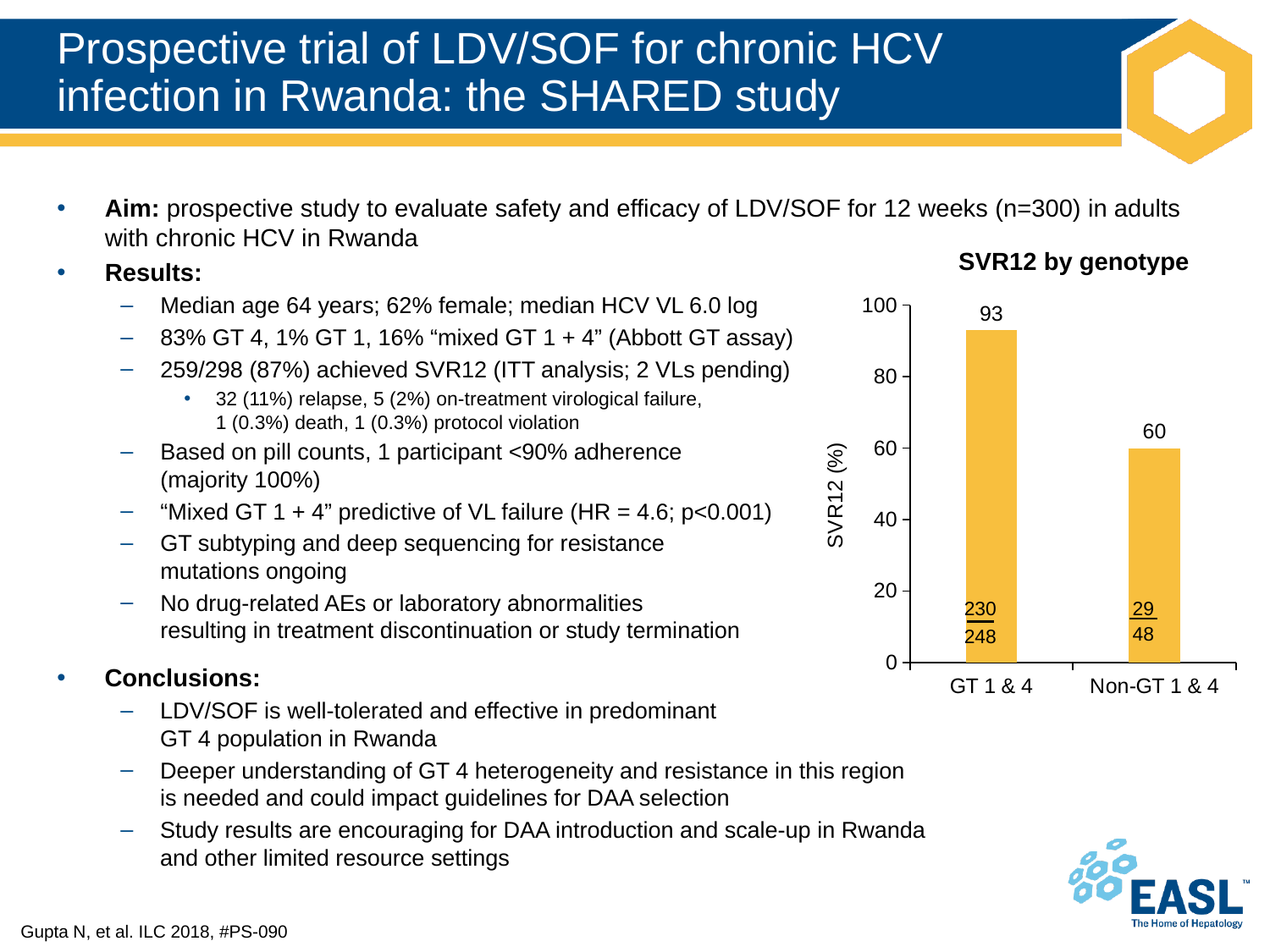
What is the SVR12 value for GT 1 & 4? 93 What fraction is printed on the GT 1 & 4 bar? 230/248 Which has a larger SVR12, GT 1 & 4 or Non-GT 1 & 4? GT 1 & 4 Is the SVR12 value for Non-GT 1 & 4 greater or less than 80? less How many genotype categories are shown in the chart? 2 Which genotype group has the highest SVR12? GT 1 & 4 What is the title of the chart? SVR12 by genotype What is the label of the y axis? SVR12 (%) What is the SVR12 value for Non-GT 1 & 4? 60 Which genotype group has the lowest SVR12? Non-GT 1 & 4 What is the difference in SVR12 between GT 1 & 4 and Non-GT 1 & 4? 33 What kind of chart is shown on the slide? bar chart